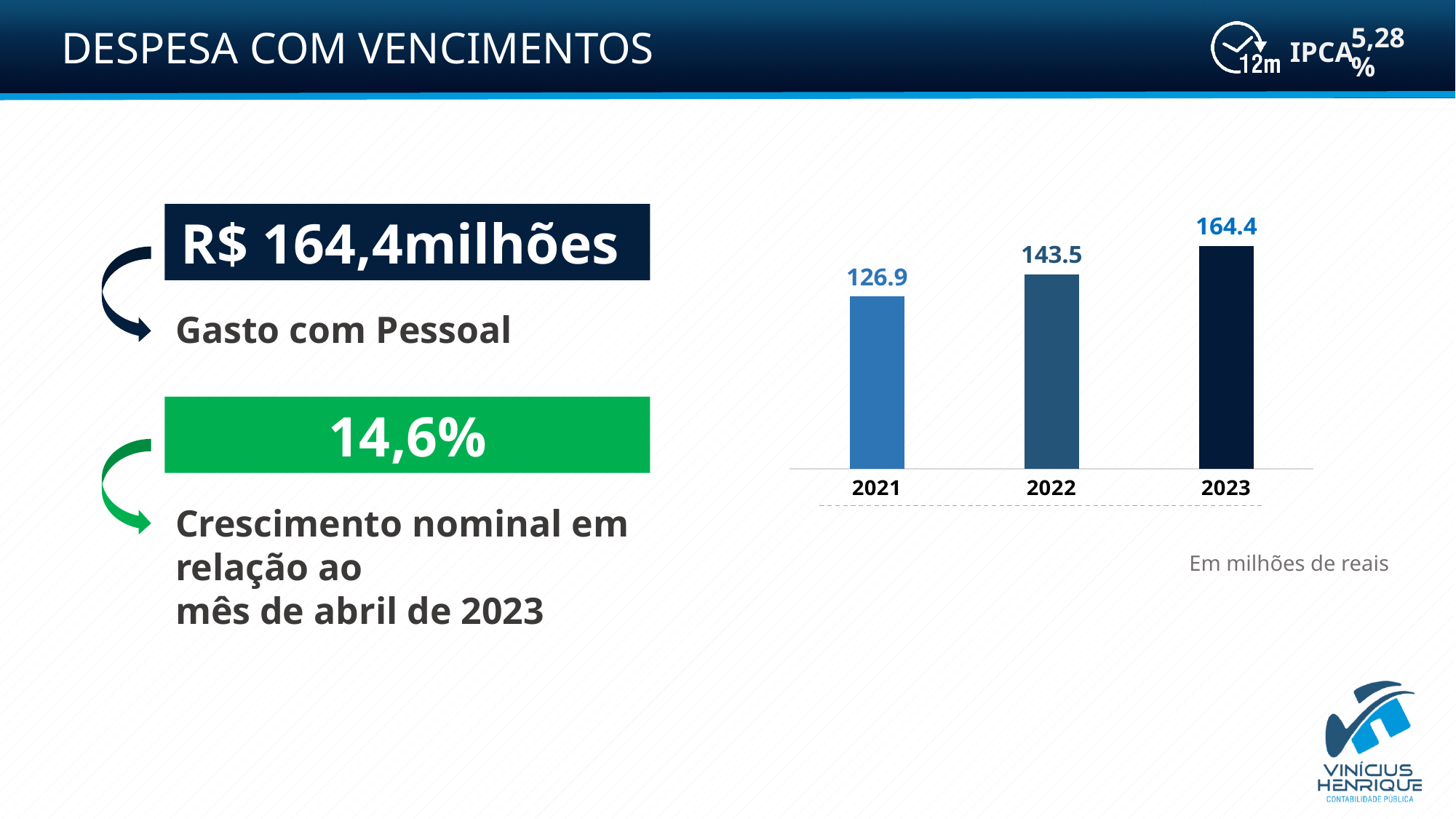
What is the difference between the values for 2023 and 2022? 20.9 What kind of chart is shown on the slide? bar chart What is the value for 2023 in the chart? 164.4 Do the values rise or fall from 2021 to 2023? rise What unit is stated below the chart? Em milhões de reais Which year has the highest value in the chart? 2023 Which year has the lowest value in the chart? 2021 What is the value for 2022 in the chart? 143.5 What is the difference between the values for 2022 and 2021? 16.6 How many bars are shown in the chart? 3 What is the value for 2021 in the chart? 126.9 Which is larger, the value for 2021 or the value for 2022? 2022